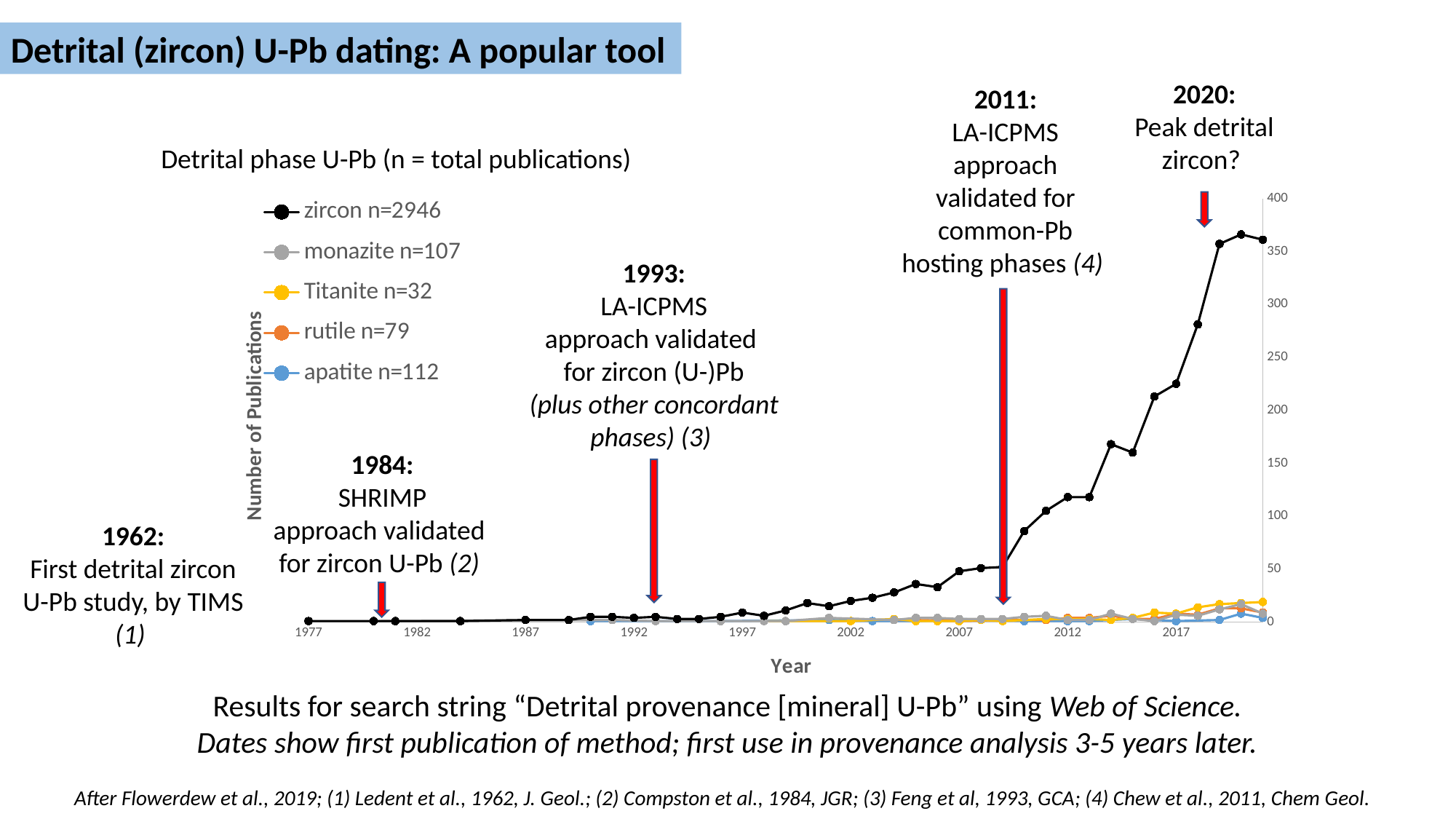
Does the zircon line generally rise or fall from 1977 to 2020? rise What is the total number of publications (n) given in the legend for zircon? 2946 Which mineral has the lowest total number of publications according to the legend? Titanite Which mineral has the highest total number of publications according to the legend? zircon Which has more total publications in the legend, rutile or monazite? monazite Is the peak value of the zircon line (around 2020) greater or less than 350? greater What is the total number of publications (n) given in the legend for apatite? 112 What is the title of the chart? Detrital phase U-Pb (n = total publications) What is the difference between the total publications for apatite and monazite given in the legend? 5 How many series does the legend list? 5 What is the label of the vertical axis? Number of Publications What kind of chart is shown on the slide? line chart